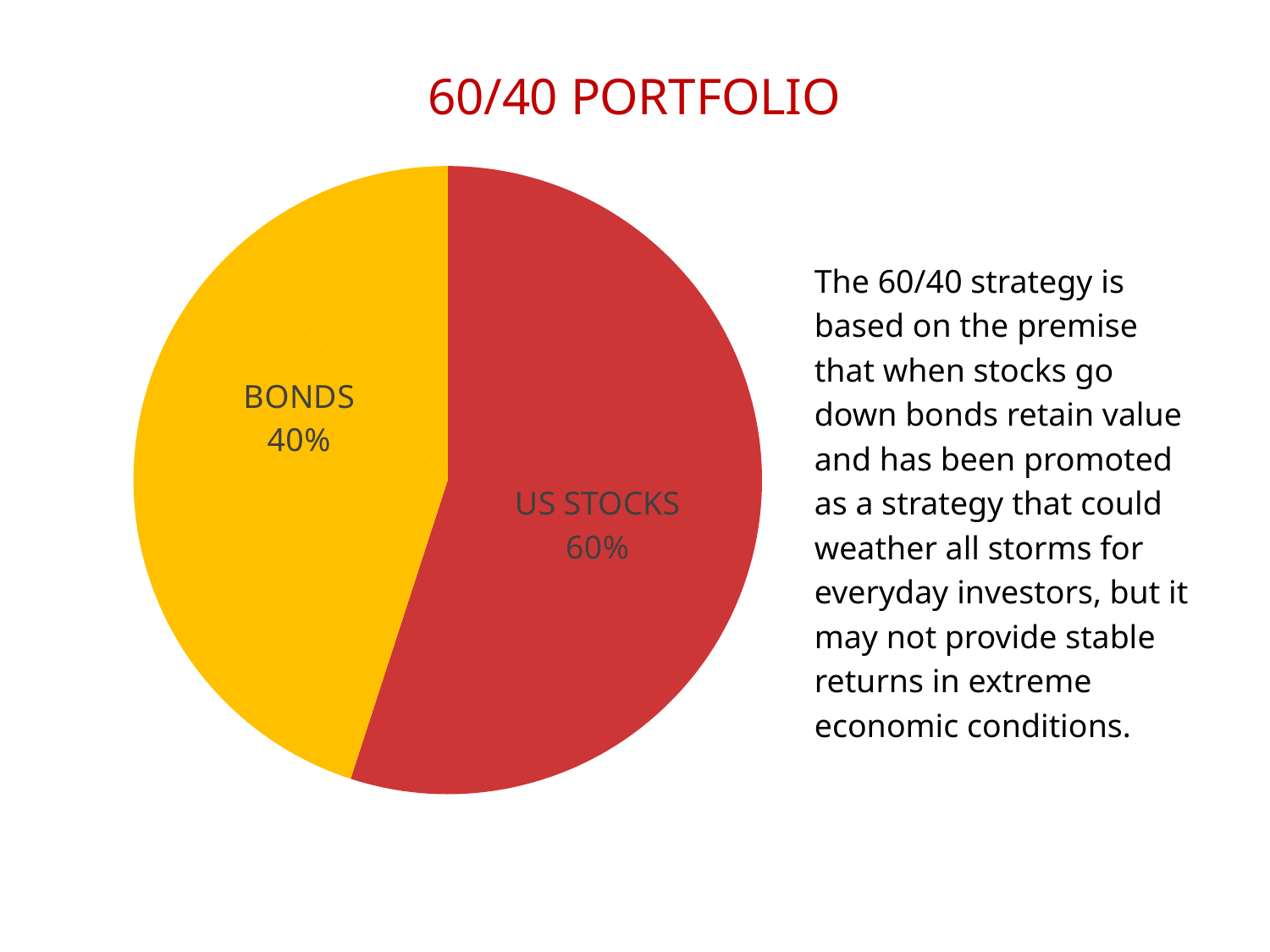
What share of the pie is BONDS? 40% What is the difference between the US STOCKS share and the BONDS share? 20% What share of the pie is US STOCKS? 60% What colour is the US STOCKS slice? red Which slice is the largest? US STOCKS What is the title of the chart? 60/40 PORTFOLIO Which slice is the smallest? BONDS What kind of chart is shown on the slide? pie chart How many slices does the pie chart have? 2 Which is larger, the BONDS slice or the US STOCKS slice? US STOCKS What is the total of the two slices shown? 100%